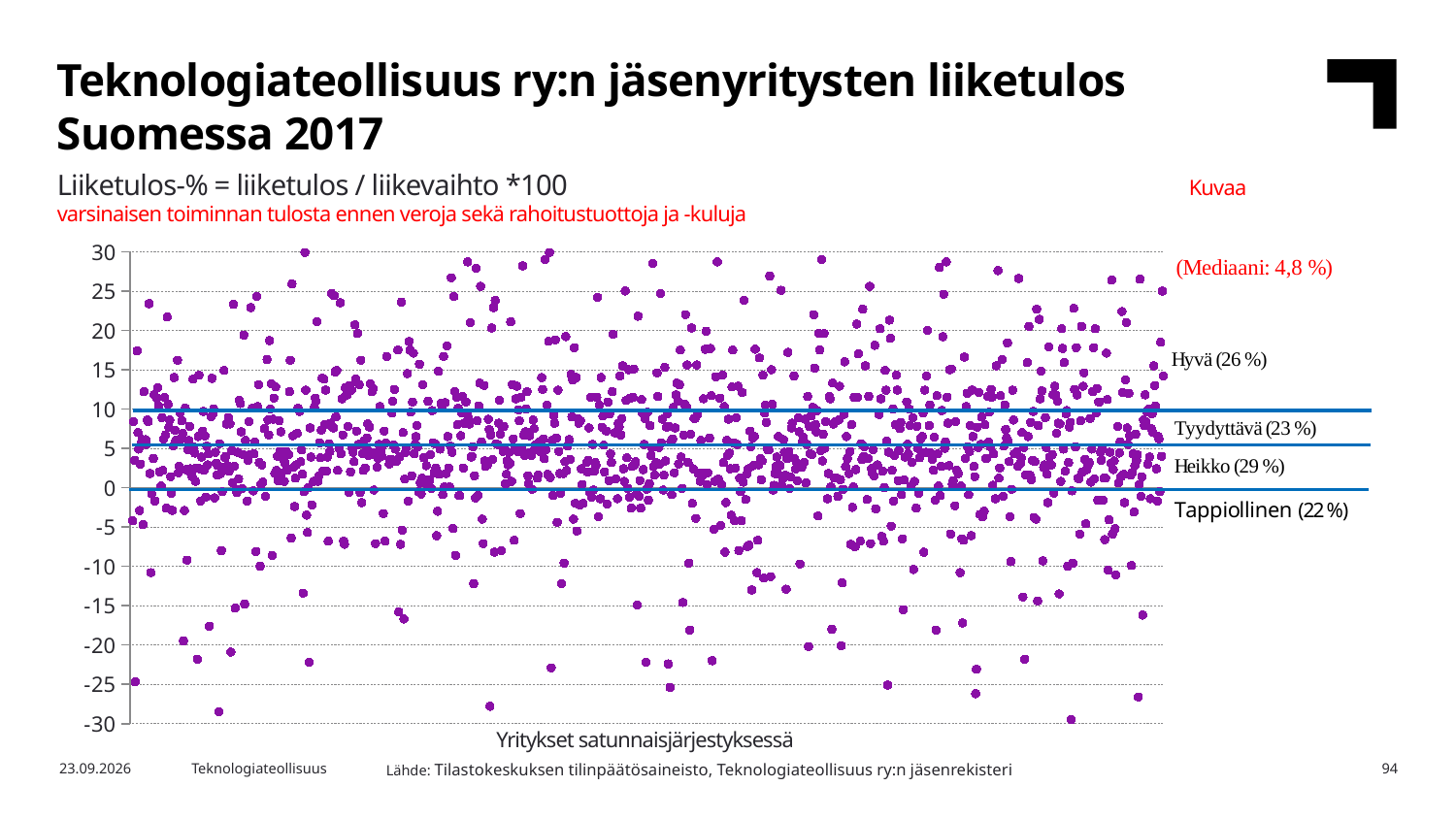
What is the difference in percentage points between the Heikko share and the Tappiollinen share? 7 What share of companies is labelled Tappiollinen on the chart? 22 % What is the label under the horizontal axis of the chart? Yritykset satunnaisjärjestyksessä Which group has a larger share, Hyvä or Tyydyttävä? Hyvä What share of companies is labelled Hyvä on the chart? 26 % Which of the four labelled groups (Hyvä, Tyydyttävä, Heikko, Tappiollinen) has the smallest share? Tappiollinen What share of companies is labelled Tyydyttävä on the chart? 23 % What kind of chart is shown on the slide? Scatter chart What is the highest value shown on the vertical axis of the chart? 30 What is the median (Mediaani) value shown on the chart? 4,8 % Which of the four labelled groups (Hyvä, Tyydyttävä, Heikko, Tappiollinen) has the largest share? Heikko What share of companies is labelled Heikko on the chart? 29 %